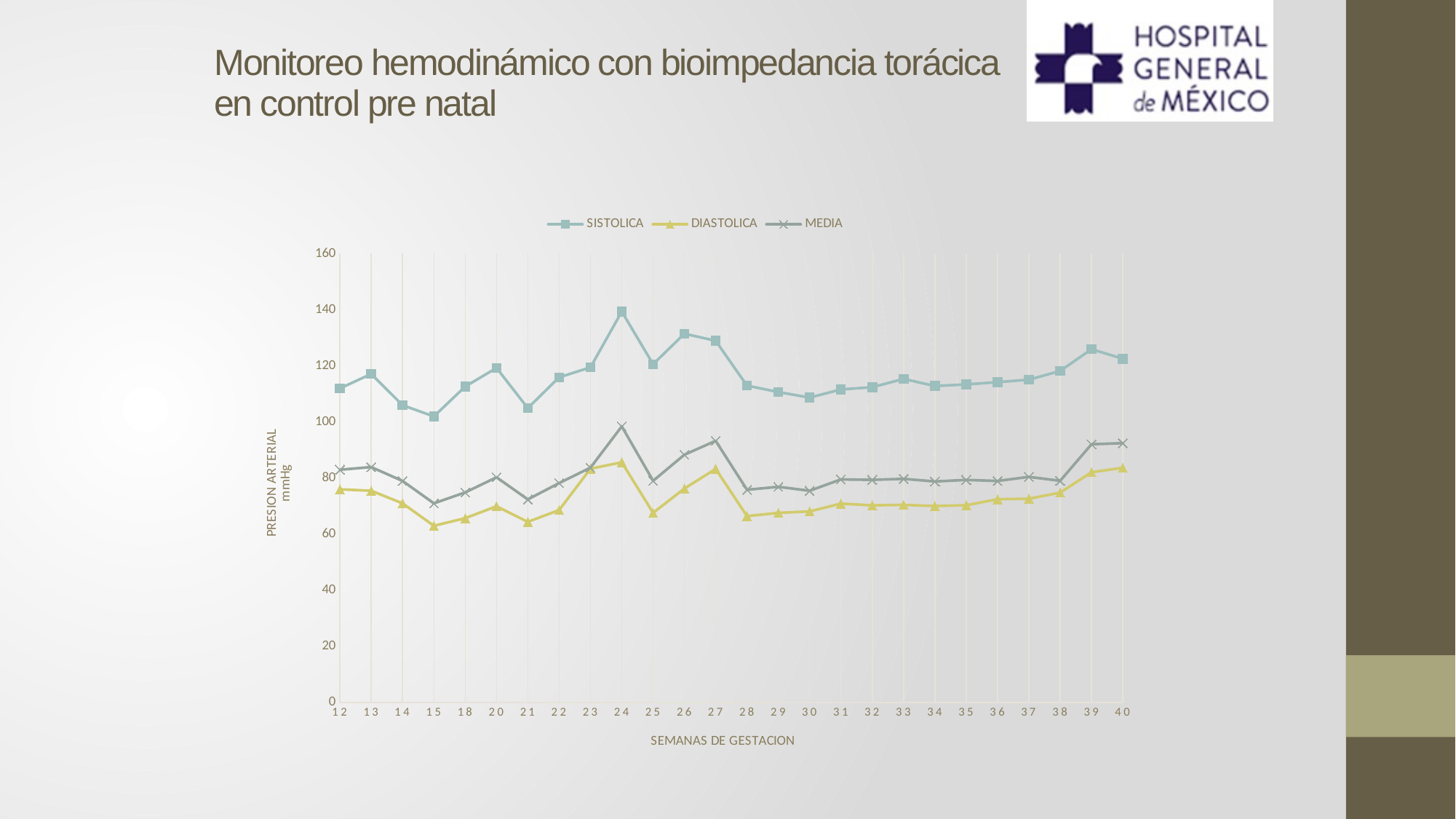
At which gestation week does the MEDIA series reach its highest value? 24 What kind of chart is shown on the slide? line chart Is the MEDIA value at week 40 greater or less than 80? greater How many series does the legend list? 3 Which is larger, the SISTOLICA value at week 24 or at week 30? week 24 Is the SISTOLICA value at week 15 greater or less than 120? less At which gestation week does the SISTOLICA series reach its highest value? 24 Which series are listed in the legend? SISTOLICA, DIASTOLICA, MEDIA Is the DIASTOLICA value at week 15 greater or less than 80? less How many gestation weeks are plotted along the x axis? 26 What is the label of the x axis? SEMANAS DE GESTACION